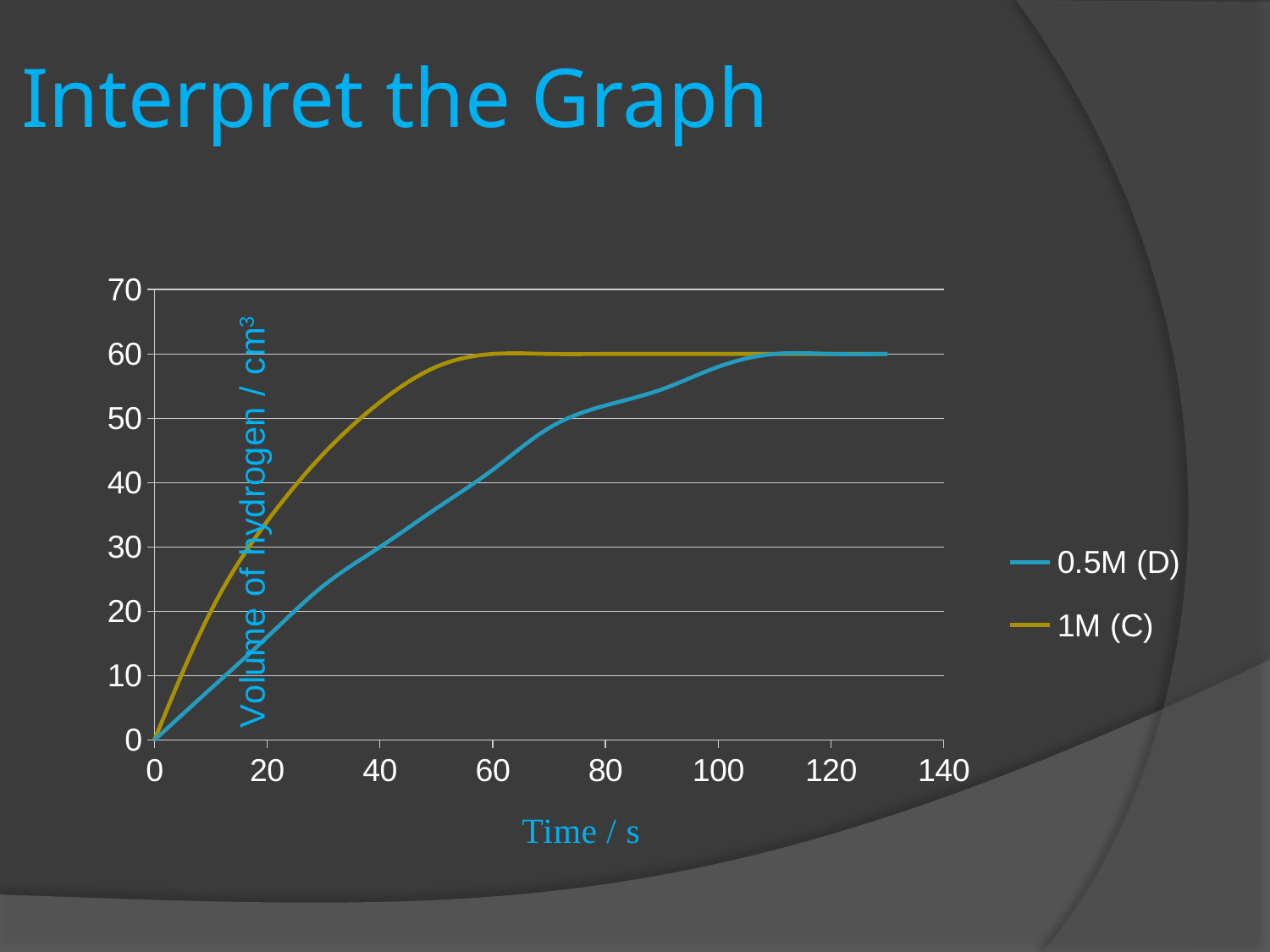
Is the value for 1M (C) at 80 s greater or less than 50? greater What kind of chart is shown on the slide? line chart What is the title of the x axis? Time / s Which series takes longer to level off, 0.5M (D) or 1M (C)? 0.5M (D) What are the two series named in the legend? 0.5M (D) and 1M (C) How does the volume of hydrogen for 1M (C) change as time increases? rises then levels off At 40 s, which series has the higher volume of hydrogen? 1M (C) Is the value for 1M (C) at 50 s greater or less than 50? greater How many series does the legend list? 2 Is the value for 0.5M (D) at 120 s greater or less than 50? greater Which series rises faster at the start, 0.5M (D) or 1M (C)? 1M (C)